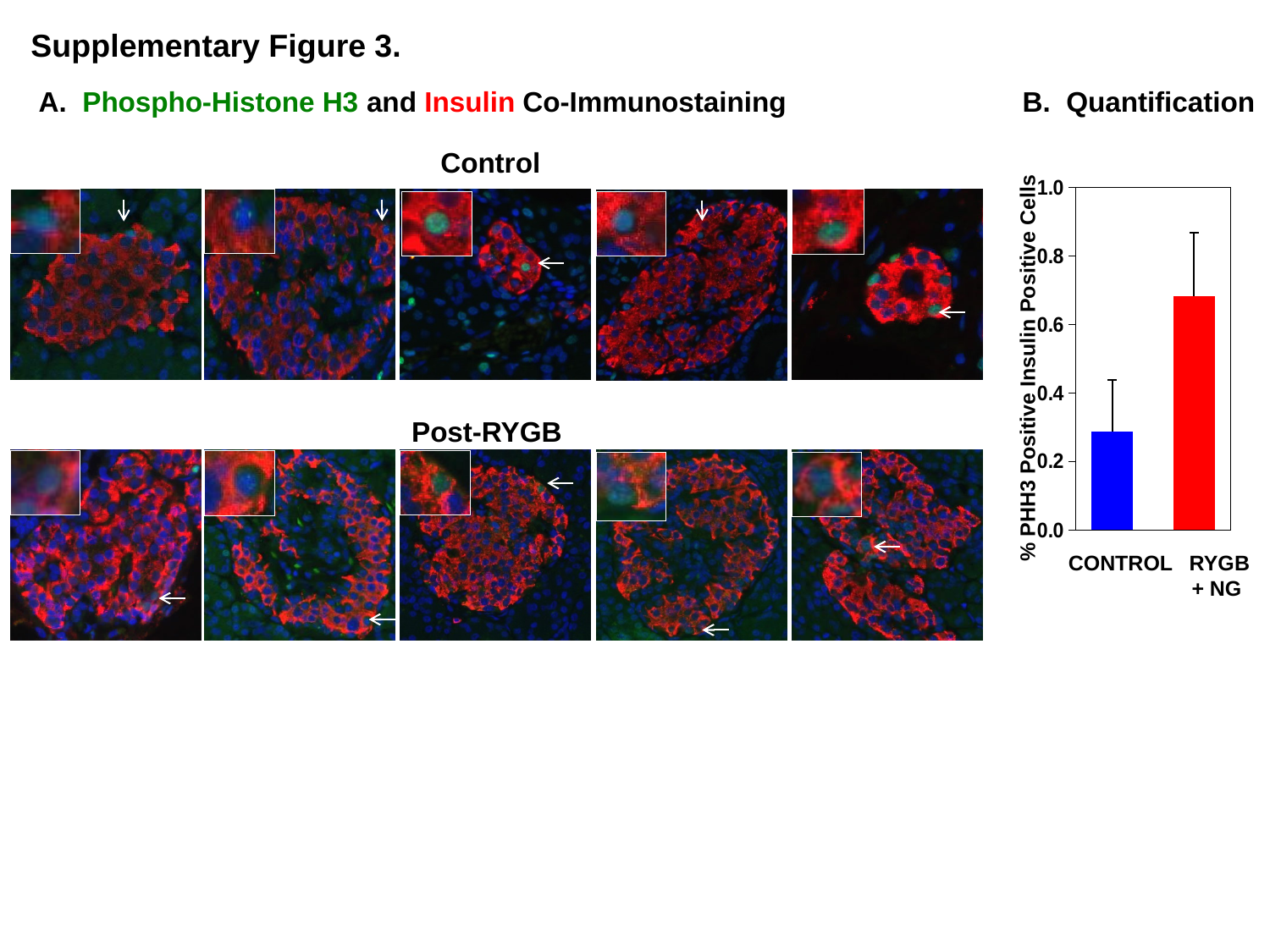
What is the y-axis label of the Quantification chart? % PHH3 Positive Insulin Positive Cells How many bars are plotted in the Quantification chart? 2 In the Quantification chart, which category has the highest value? RYGB + NG In the Quantification chart, is the value for CONTROL greater or less than 0.4? less In the Quantification chart, is the value for RYGB + NG greater or less than 0.6? greater In the Quantification chart, what colour is the RYGB + NG bar? red What kind of chart is shown in panel B, Quantification? bar chart In the Quantification chart, is the value for RYGB + NG greater or less than 0.8? less In the Quantification chart, which category has the lowest value? CONTROL In the Quantification chart, which is larger, the value for CONTROL or the value for RYGB + NG? RYGB + NG In the Quantification chart, do the bar values rise or fall going from CONTROL to RYGB + NG? rise